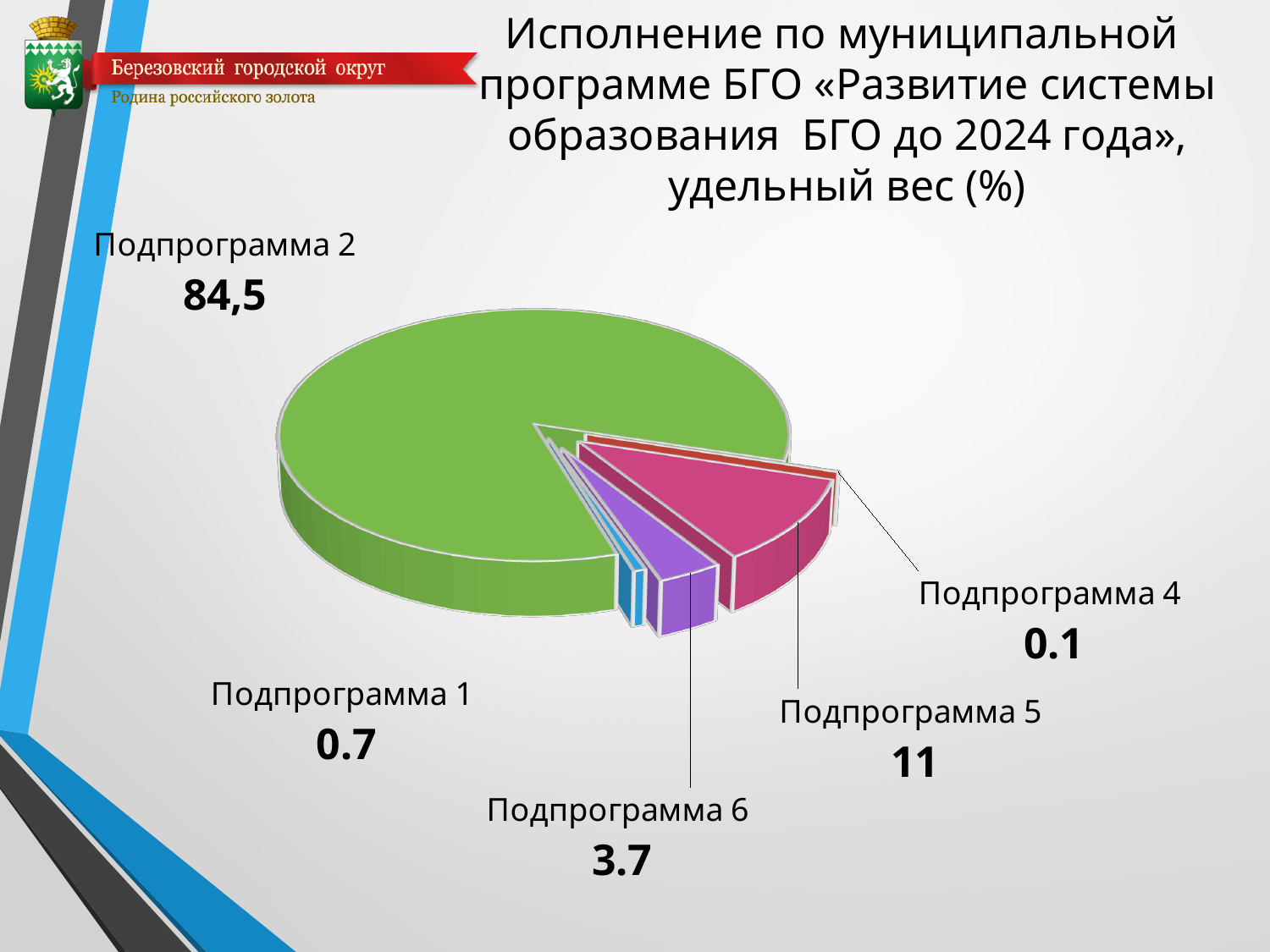
What colour is the slice for Подпрограмма 2? Green What is the value shown for Подпрограмма 6? 3.7 How many subprograms are labelled on the pie chart? 5 Which subprogram has the smallest share of the pie? Подпрограмма 4 What is the difference between the values for Подпрограмма 5 and Подпрограмма 6? 7.3 What kind of chart is shown on the slide? Pie chart Which subprogram has the largest share of the pie? Подпрограмма 2 What is the value shown for Подпрограмма 2? 84,5 Which is larger, the value for Подпрограмма 6 or the value for Подпрограмма 1? Подпрограмма 6 What is the value shown for Подпрограмма 1? 0.7 What is the value shown for Подпрограмма 5? 11 What is the value shown for Подпрограмма 4? 0.1